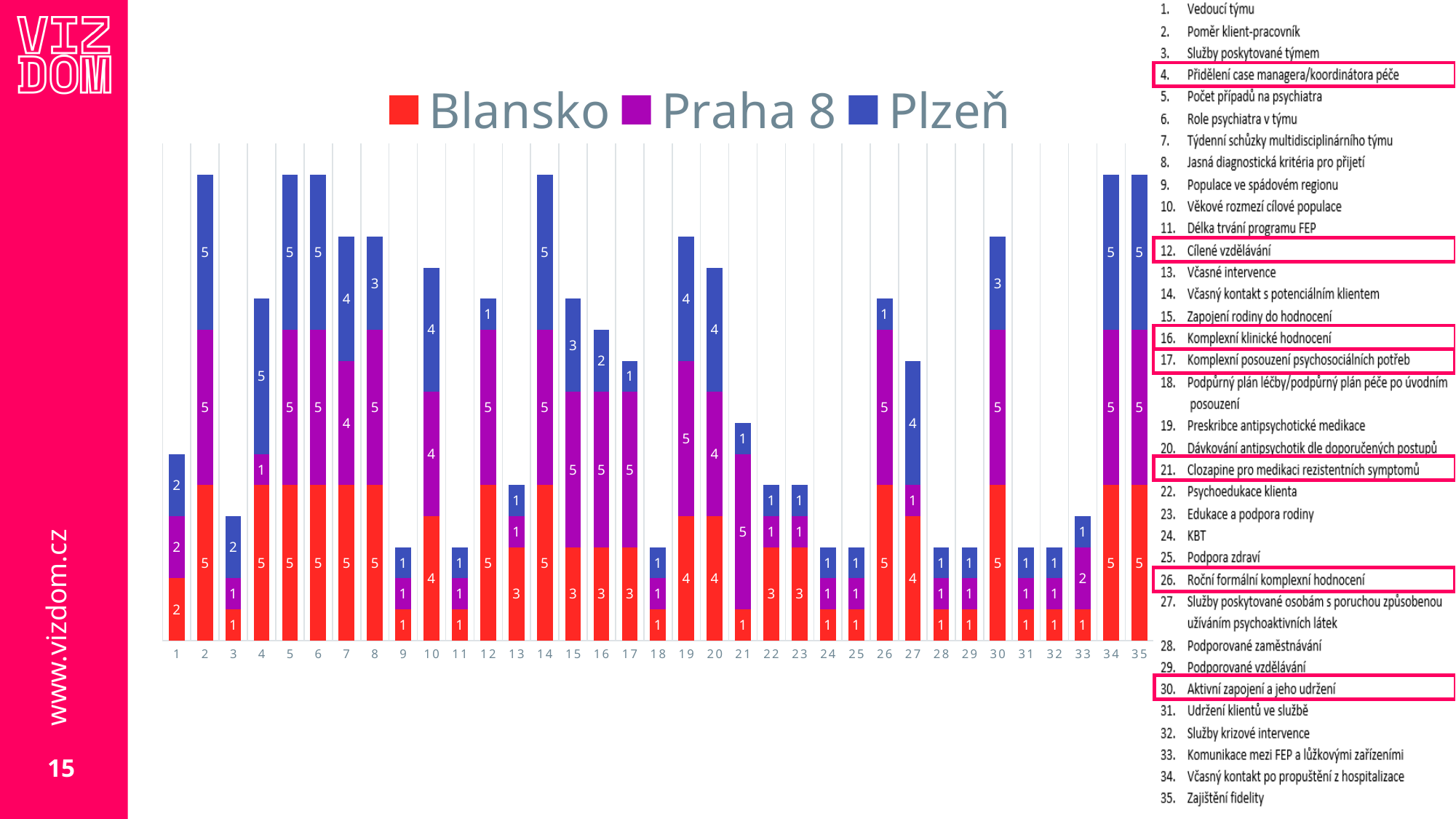
What is the Plzeň value for category 1? 2 What is the total of the stacked bar for category 2? 15 What is the total of the stacked bar for category 33? 4 What is the total of the stacked bar for category 21? 7 How many categories are plotted along the x axis? 35 Which is larger for category 13: the Blansko value or the Plzeň value? Blansko What is the Praha 8 value for category 16? 5 What is the difference between the Praha 8 value and the Blansko value for category 21? 4 Which series is shown in red in the legend? Blansko How many series does the legend list? 3 What type of chart is shown on the slide? stacked bar chart What is the Blansko value for category 27? 4